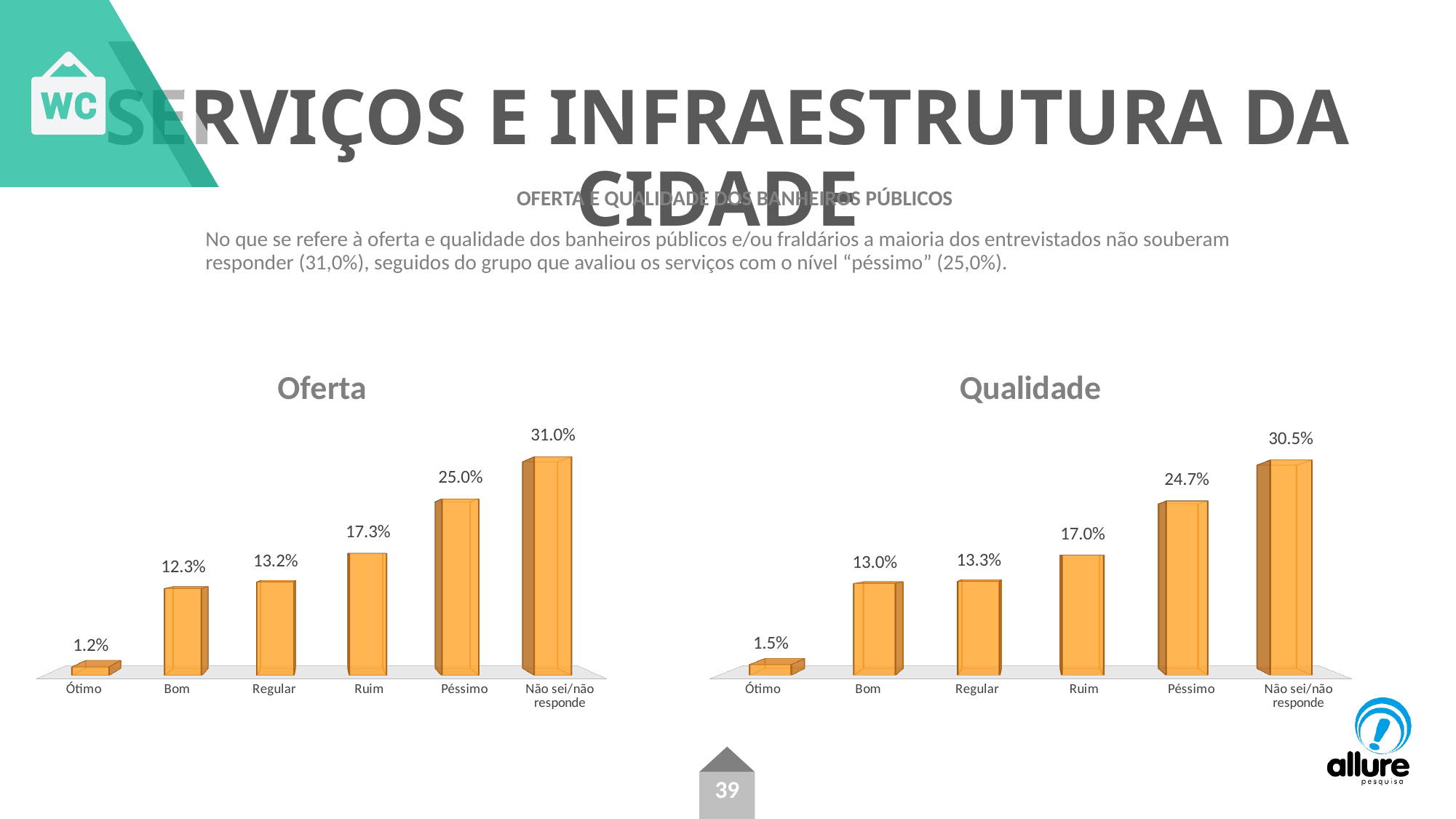
In the 'Oferta' chart, do the values rise or fall from 'Ótimo' to 'Não sei/não responde'? Rise In the 'Qualidade' chart, what is the value for 'Regular'? 13.3% What type of chart is the 'Oferta' chart? Bar chart In the 'Qualidade' chart, what is the value for 'Péssimo'? 24.7% How many categories are shown in the 'Qualidade' chart? 6 In the 'Qualidade' chart, which category has the highest value? Não sei/não responde In the 'Oferta' chart, what is the value for 'Não sei/não responde'? 31.0% In the 'Qualidade' chart, what is the difference between 'Não sei/não responde' and 'Péssimo'? 5.8% In the 'Oferta' chart, which category has the lowest value? Ótimo In the 'Oferta' chart, what is the difference between 'Péssimo' and 'Ruim'? 7.7% Which chart has the higher value for 'Ótimo', 'Oferta' or 'Qualidade'? Qualidade In the 'Oferta' chart, which is larger: 'Bom' or 'Ruim'? Ruim